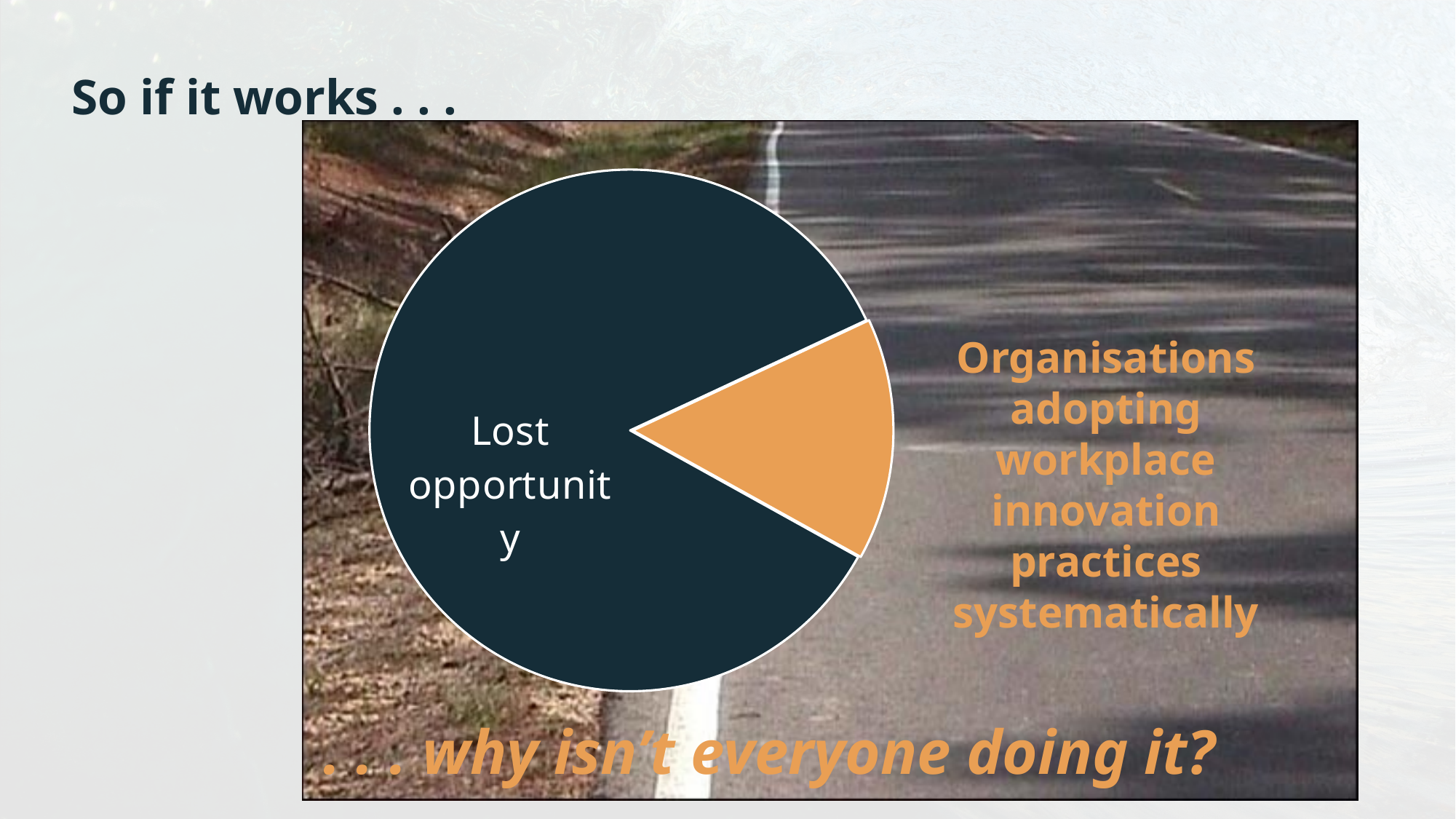
Which is larger in the pie chart: the 'Lost opportunity' slice or the 'Organisations adopting workplace innovation practices systematically' slice? Lost opportunity What colour is the 'Lost opportunity' slice of the pie chart? dark blue What kind of chart is shown on the slide? pie chart How many slices does the pie chart have? 2 Which slice of the pie chart is the smallest? Organisations adopting workplace innovation practices systematically What colour is the 'Organisations adopting workplace innovation practices systematically' slice of the pie chart? orange Which slice of the pie chart is the largest? Lost opportunity